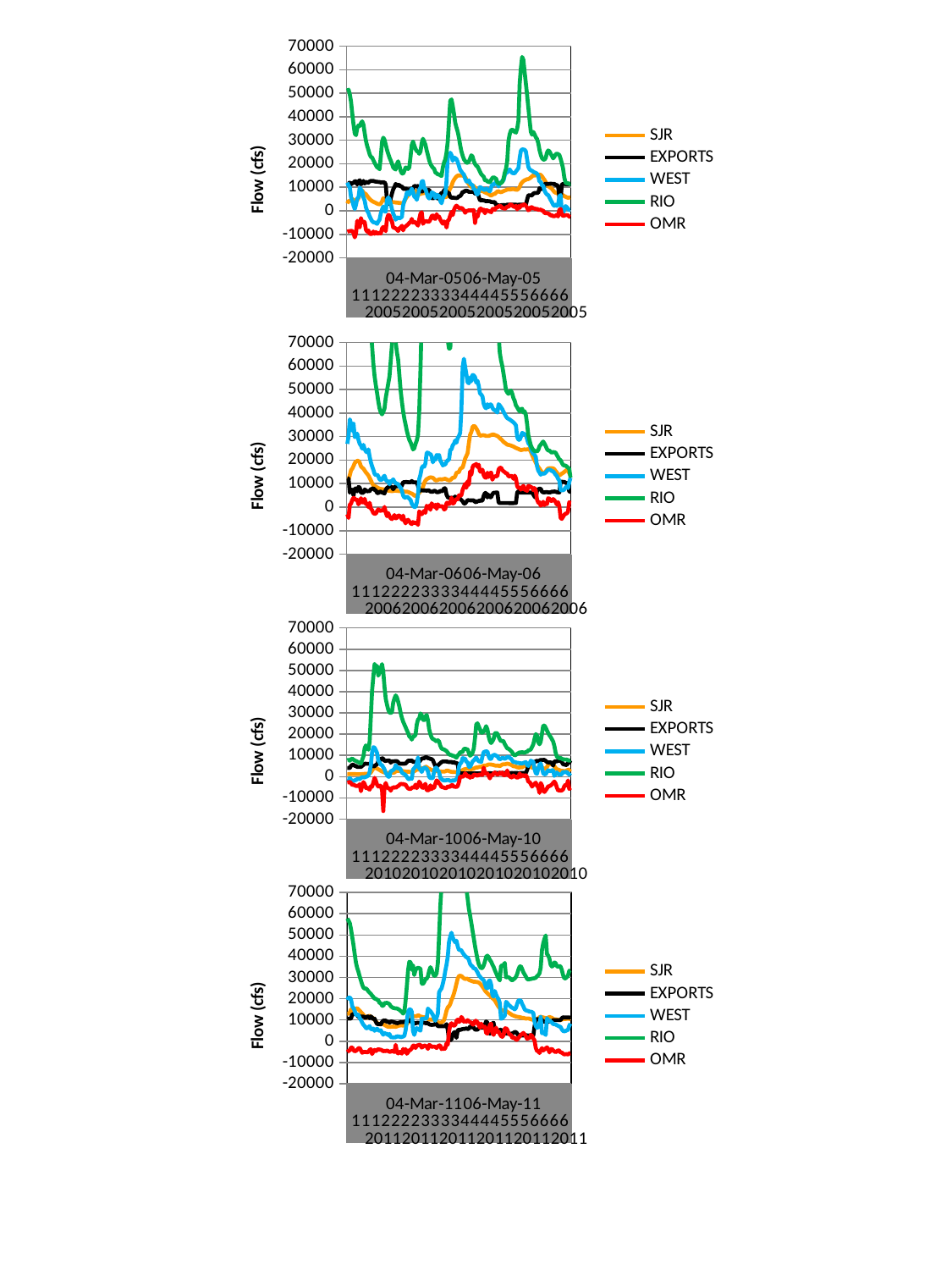
How many charts are shown on the slide? 4 What kind of chart is the top chart on the slide? line chart In the top chart (2005), is the lowest value of OMR greater or less than 0? less Which series is drawn in green in the legend of the bottom chart? RIO In the top chart (2005), is the peak value of RIO greater or less than 50000? greater In the third chart (2010), which series reaches the lowest (most negative) flow values? OMR What is the y-axis title of the charts on the slide? Flow (cfs) In the third chart (2010), is the peak value of RIO greater or less than 40000? greater How many series does the legend of the top chart list? 5 In the second chart (2006), which series has the higher peak, WEST or SJR? WEST In the top chart (2005), which series reaches the highest flow values? RIO